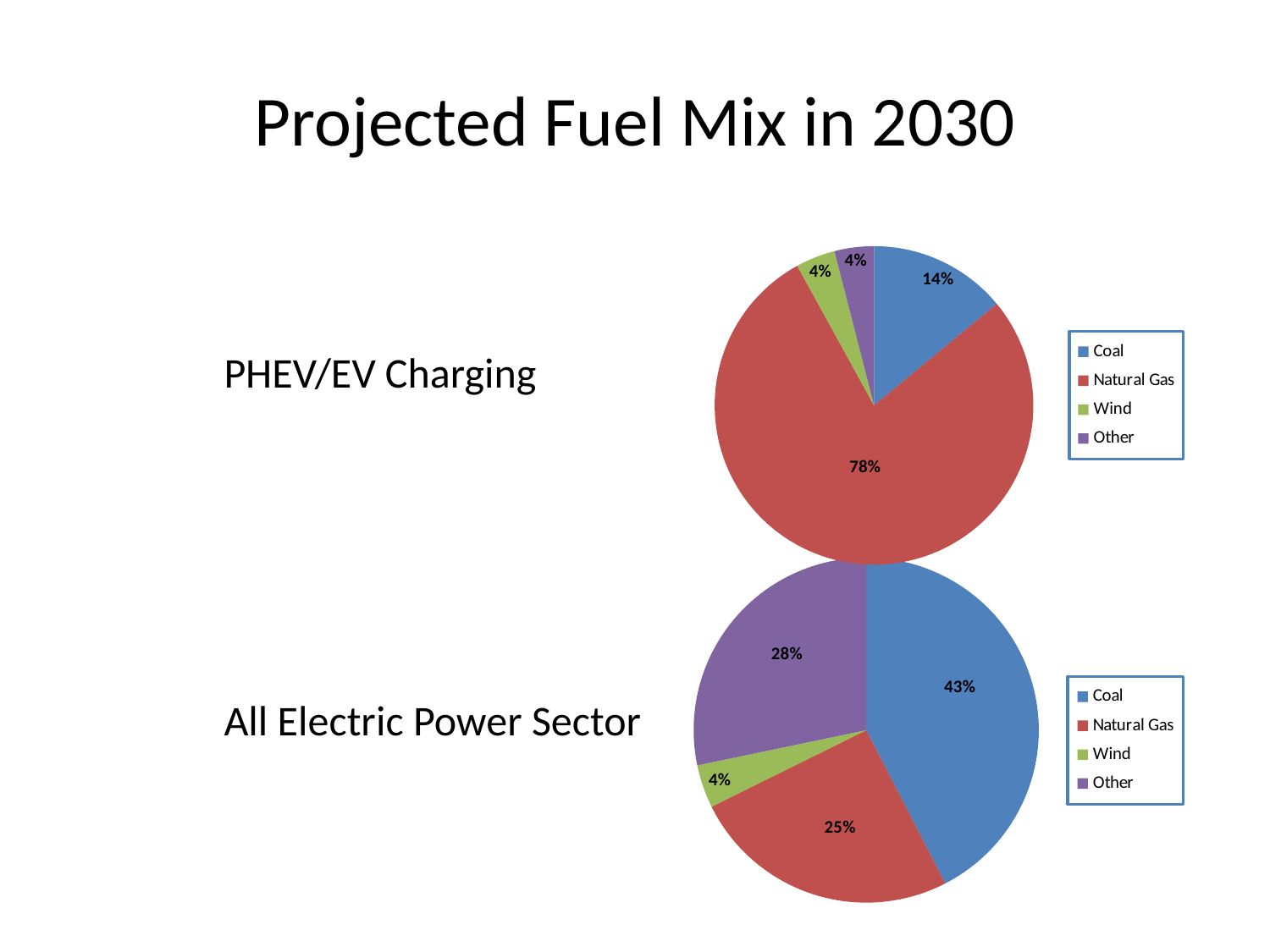
In the PHEV/EV Charging pie chart, what share does Coal have? 14% How many categories does the legend of the All Electric Power Sector pie chart list? 4 In the All Electric Power Sector pie chart, what share does Coal have? 43% What type of chart is used for the PHEV/EV Charging data? Pie chart In the All Electric Power Sector pie chart, which category has the smallest share? Wind In the All Electric Power Sector pie chart, which category has the largest share? Coal In the All Electric Power Sector pie chart, what share does Other have? 28% In the PHEV/EV Charging pie chart, which is larger, the Coal share or the Wind share? Coal In the PHEV/EV Charging pie chart, what share does Natural Gas have? 78% In the All Electric Power Sector pie chart, what share does Natural Gas have? 25% In the All Electric Power Sector pie chart, what is the difference between the Coal share and the Natural Gas share? 18% In the PHEV/EV Charging pie chart, which category has the largest share? Natural Gas